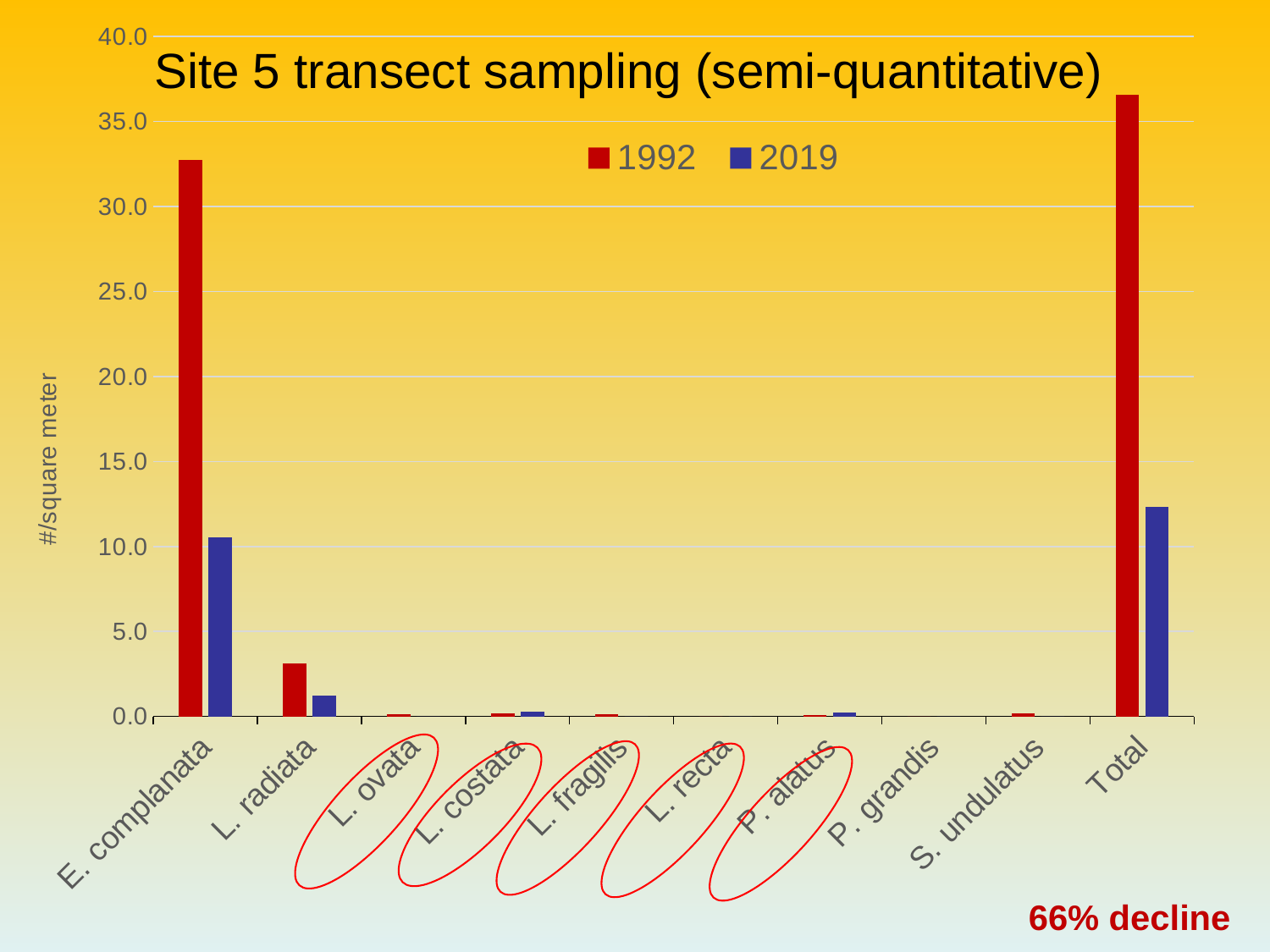
For E. complanata, which is larger: the 1992 value or the 2019 value? 1992 How many series does the legend list? 2 Excluding Total, which species has the highest 1992 value? E. complanata Which category has the highest 1992 value? Total What kind of chart is shown on the slide? bar chart Is the 2019 value for Total greater or less than 15.0? less How many categories are shown along the x axis? 10 Is the 1992 value for E. complanata greater or less than 30.0? greater Which category has the highest 2019 value? Total Is the 1992 value for Total greater or less than 35.0? greater What is the title of the chart? Site 5 transect sampling (semi-quantitative)